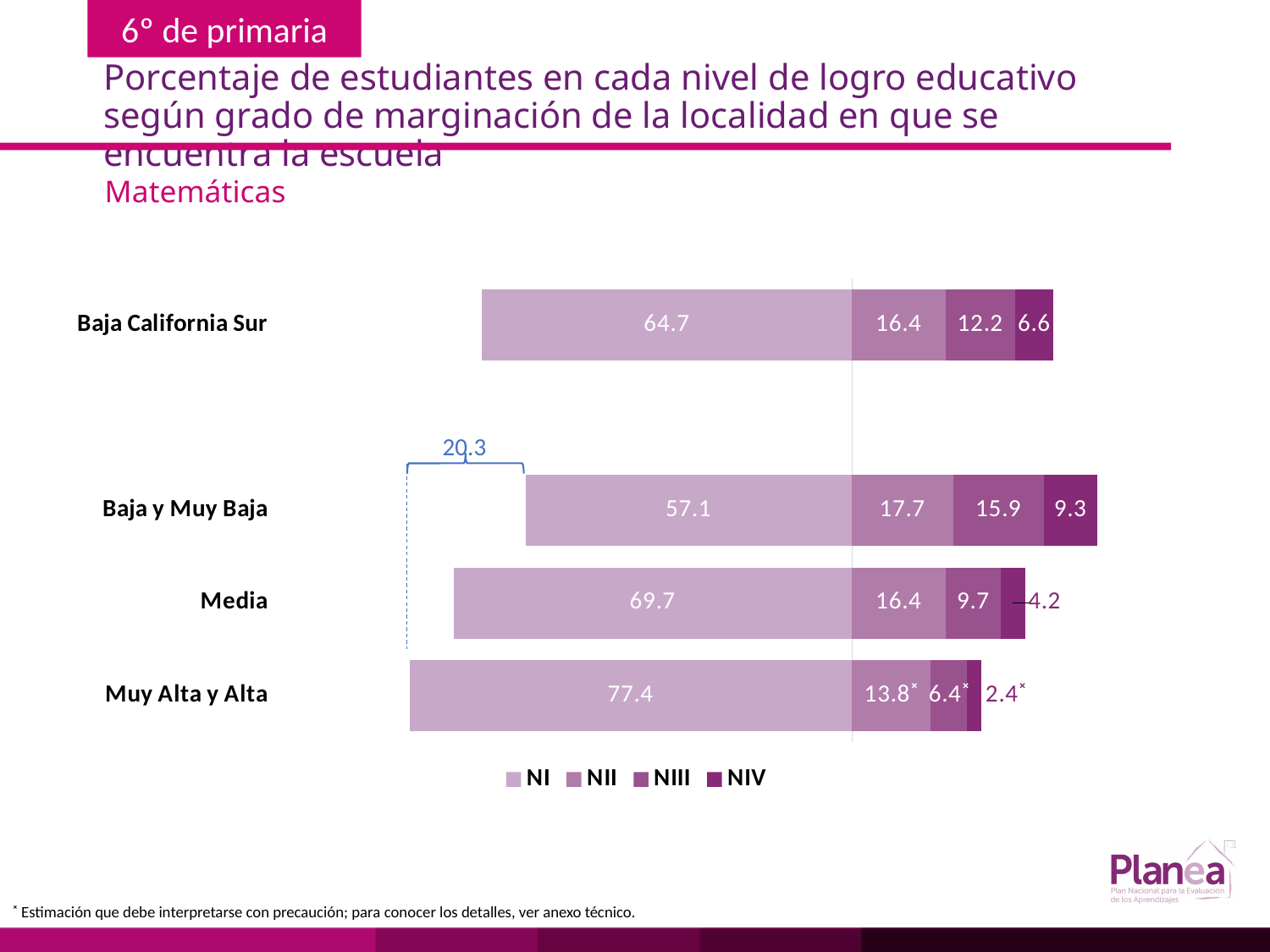
What is the NII value for Muy Alta y Alta? 13.8 How many categories are shown on the chart? 4 Which is larger: the NIII value for Baja California Sur or the NIII value for Baja y Muy Baja? Baja y Muy Baja What is the total of the stacked bar for Baja y Muy Baja? 100.0 What is the NI value for Baja California Sur? 64.7 Which category has the lowest NIV value? Muy Alta y Alta What is the difference between the NI value for Muy Alta y Alta and the NI value for Baja y Muy Baja? 20.3 What type of chart is shown on the slide? stacked bar chart How many series does the legend list? 4 What is the NIV value for Baja y Muy Baja? 9.3 Which category has the highest NI value? Muy Alta y Alta What is the NIII value for Media? 9.7